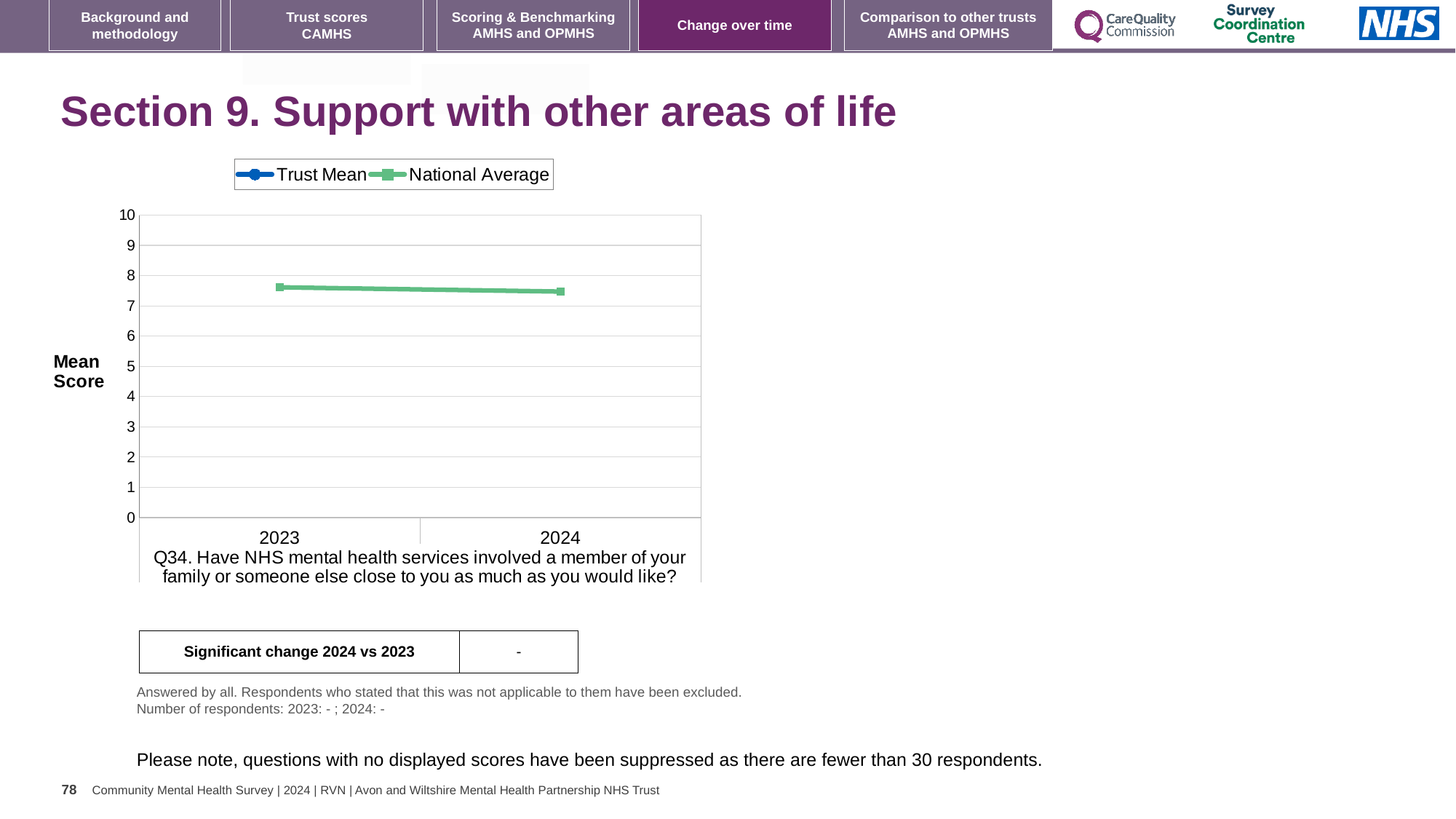
Is the National Average value for 2023 greater or less than 7? greater What kind of chart is shown on the slide? line chart Is the National Average value for 2024 greater or less than 7? greater Which series in the legend has no data plotted on the chart? Trust Mean What is the label on the y axis of the chart? Mean Score Is the National Average value for 2024 greater or less than 8? less Does the National Average line rise or fall from 2023 to 2024? fall How many series does the chart legend list? 2 How many years are shown on the x axis of the chart? 2